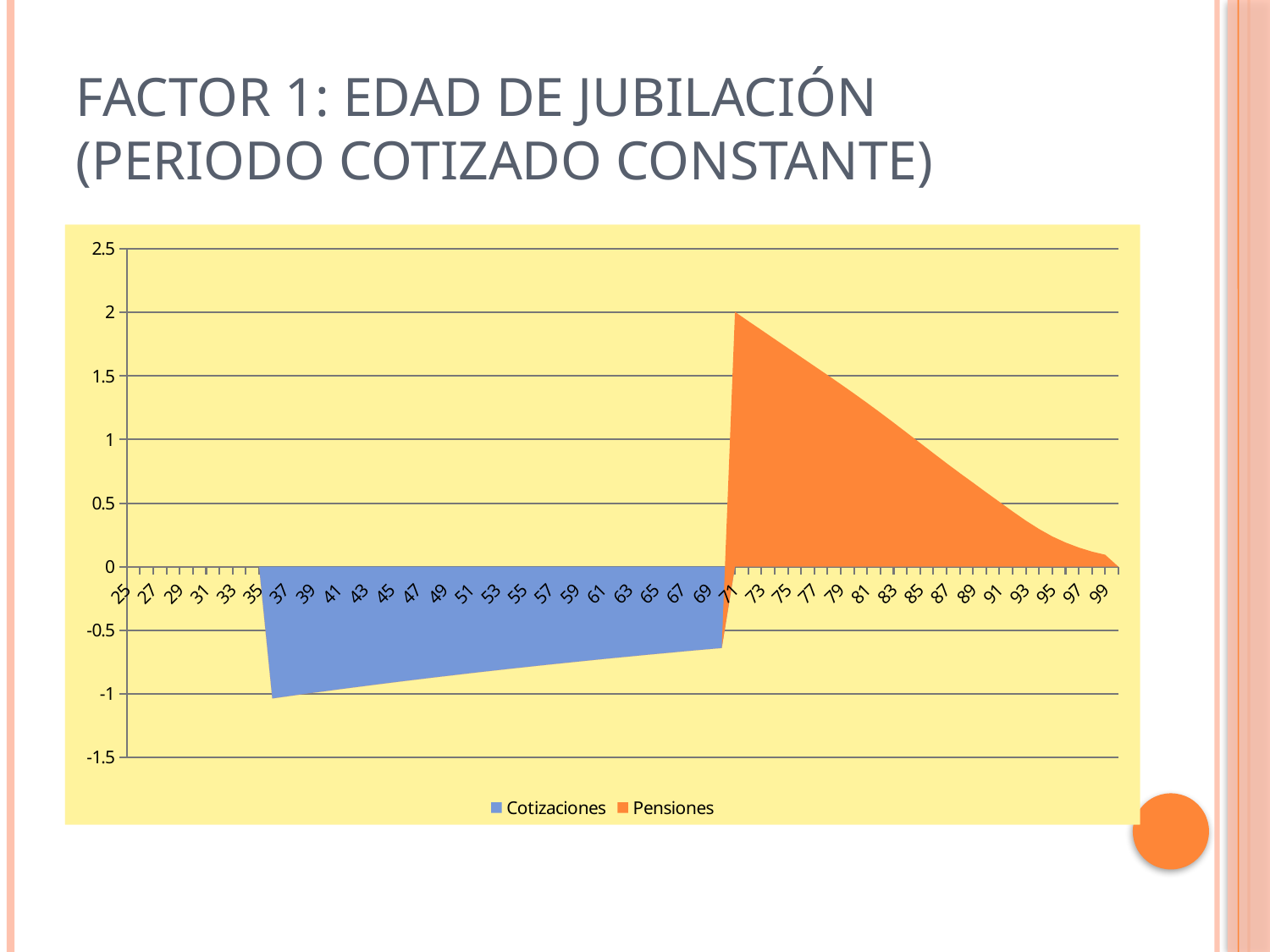
Do the Cotizaciones values rise or fall from age 37 to age 69? rise What kind of chart is shown on the slide? Area chart Is the value for Pensiones at age 71 greater or less than 1.5? greater Do the Pensiones values rise or fall from age 71 to age 99? fall Is the value for Cotizaciones at age 37 greater or less than -0.5? less What colour is used for the Pensiones series? Orange Is the value for Pensiones at age 91 greater or less than 1? less Which is larger, the Pensiones value at age 73 or at age 95? Age 73 What are the two series named in the legend? Cotizaciones and Pensiones How many series does the legend list? 2 Which series reaches the highest value on the chart? Pensiones